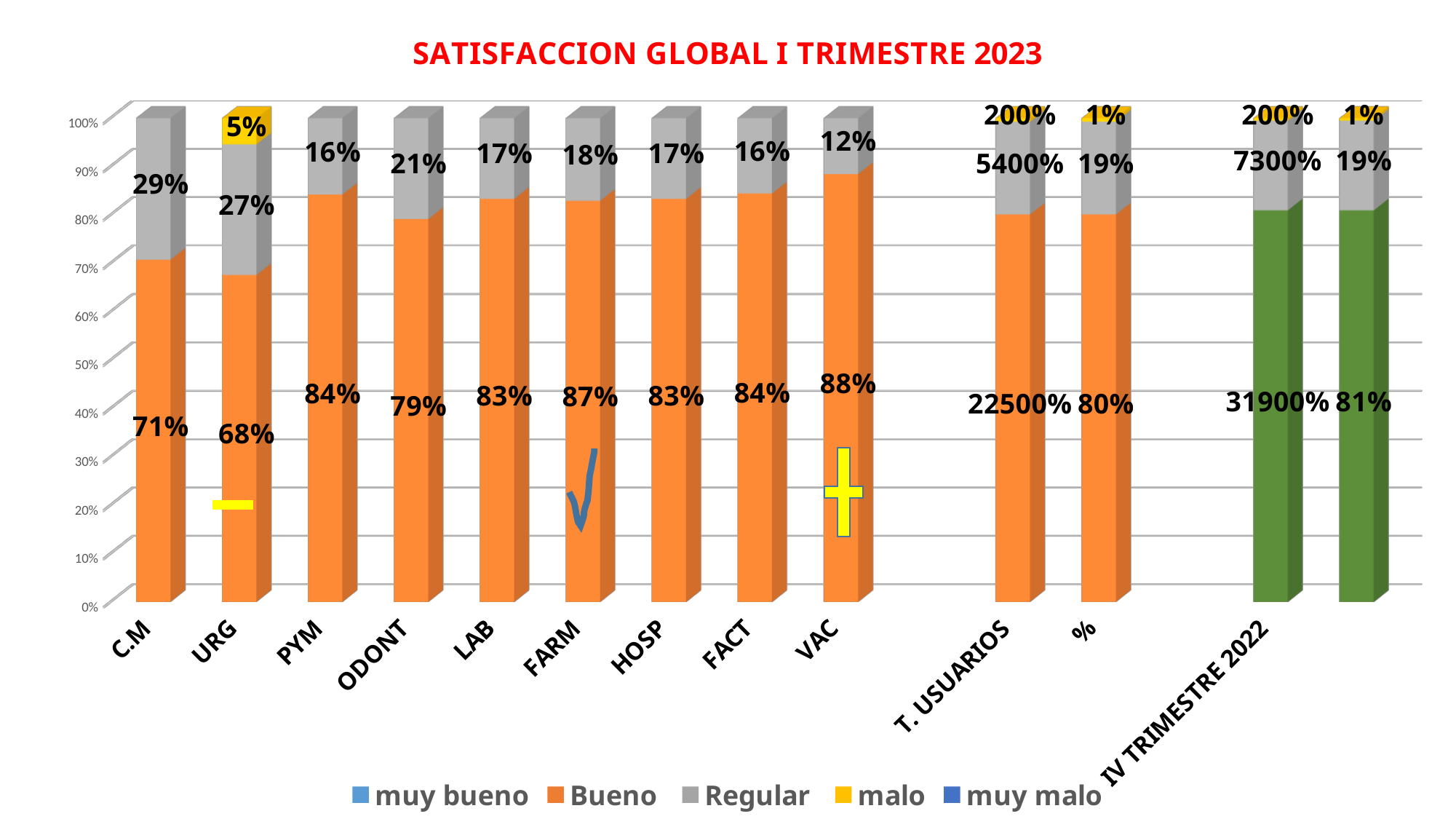
Among C.M, URG, PYM, ODONT, LAB, FARM, HOSP, FACT and VAC, which category has the highest Bueno value? VAC How many series does the legend list? 5 What is the Bueno value for C.M? 71% Among C.M, URG, PYM, ODONT, LAB, FARM, HOSP, FACT and VAC, which category has the lowest Bueno value? URG Is the Bueno value for URG greater or less than 70%? less What is the difference between the Bueno values for FARM and ODONT? 8% What is the title of the chart? SATISFACCION GLOBAL I TRIMESTRE 2023 What is the Regular value for ODONT? 21% Which has a larger Regular value, C.M or PYM? C.M What is the malo value for URG? 5% What kind of chart is shown on the slide? stacked bar chart What is the Bueno value for VAC? 88%